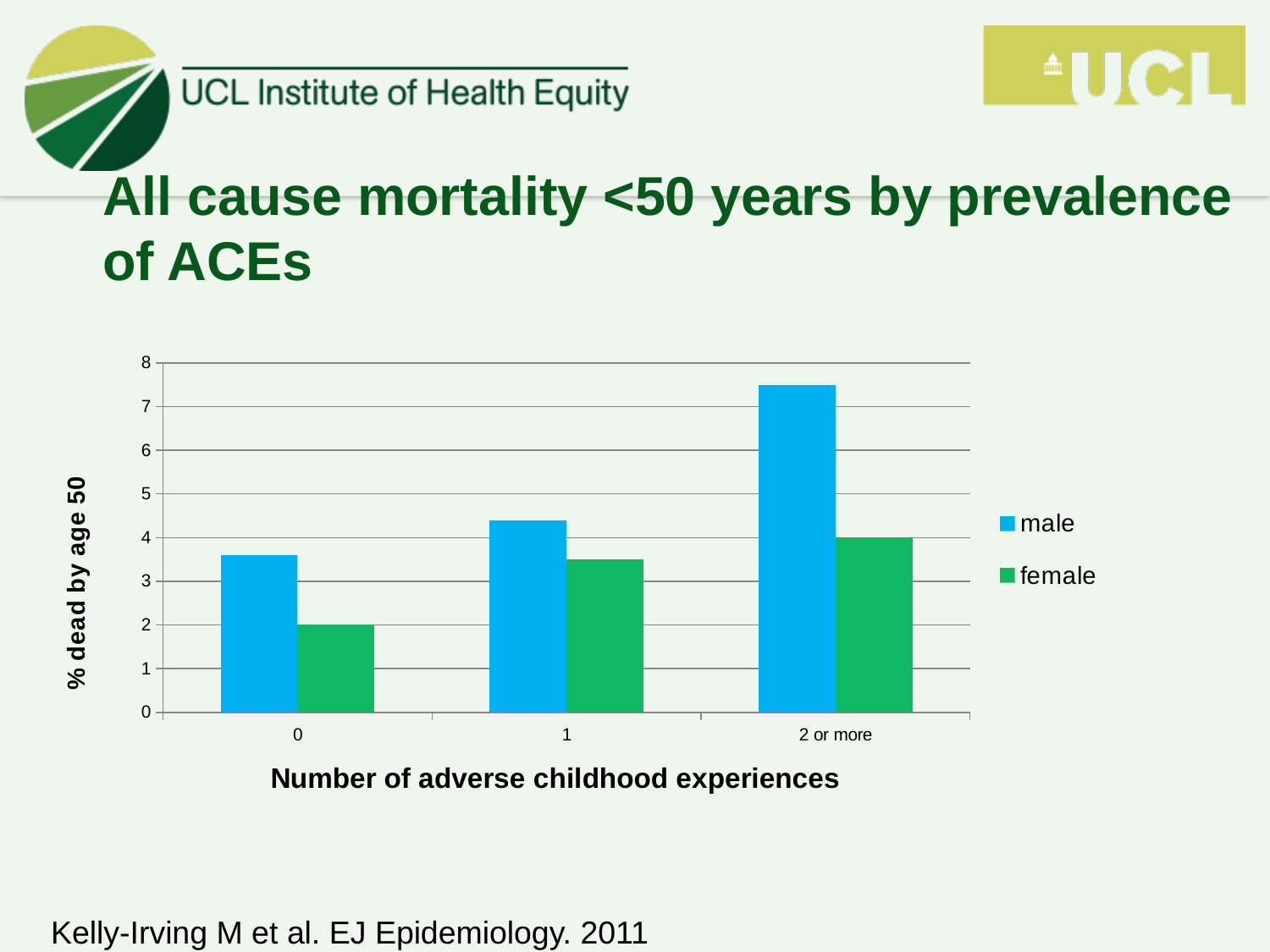
What is the label of the x axis? Number of adverse childhood experiences Is the female value for 1 adverse childhood experience greater or less than 3? greater What kind of chart is shown on the slide? bar chart What is the label of the y axis? % dead by age 50 How many categories are shown on the x axis? 3 Is the male value for 0 adverse childhood experiences greater or less than 4? less How many series does the legend list? 2 Is the male value for 2 or more adverse childhood experiences greater or less than 7? greater Which category has the highest value for the male series? 2 or more Which is larger for the category 2 or more: the male value or the female value? male Which category has the lowest value for the female series? 0 Do the male values rise or fall as the number of adverse childhood experiences increases? rise